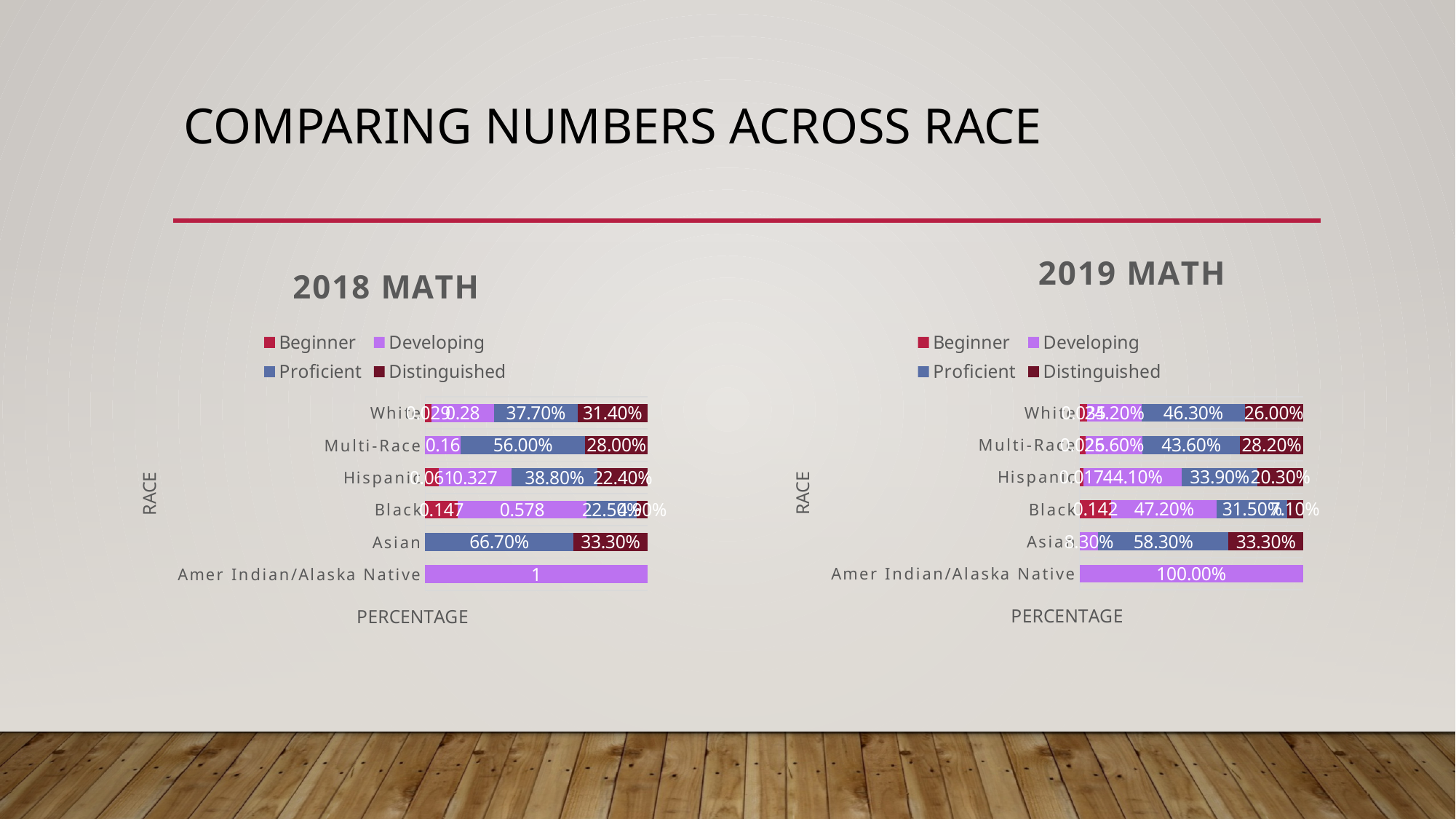
In the 2019 MATH chart, what is the Developing value for Amer Indian/Alaska Native? 100.00% In the 2019 MATH chart, which race has the highest Proficient value? Asian What type of chart is the 2018 MATH chart? Stacked bar chart In the 2019 MATH chart, which is larger, the Proficient value for Multi-Race or for Hispanic? Multi-Race How many race categories are shown in the 2018 MATH chart? 6 In the 2019 MATH chart, what is the Distinguished value for Hispanic? 20.30% In the 2018 MATH chart, what is the Proficient value for Asian? 66.70% In the 2018 MATH chart, what is the Proficient value for Multi-Race? 56.00% In the 2019 MATH chart, what is the Proficient value for White? 46.30% How many series does the legend of the 2019 MATH chart list? 4 In the 2018 MATH chart, what is the difference between the Proficient values for Asian and Multi-Race? 10.70% In the 2018 MATH chart, what is the Distinguished value for White? 31.40%